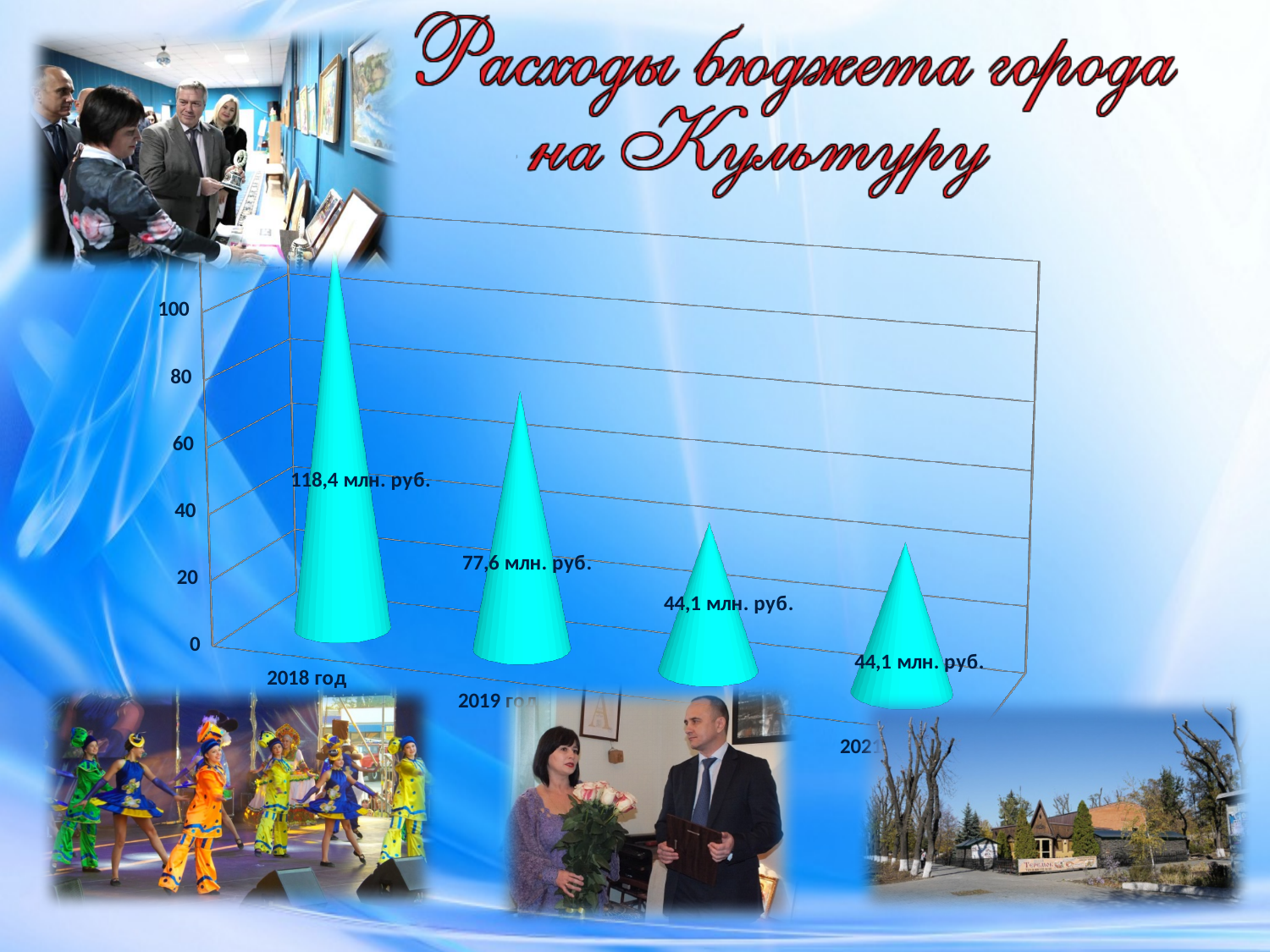
What kind of chart is shown on the slide? bar chart What is the title of the chart on the slide? Расходы бюджета города на Культуру What is the value shown for 2019 год? 77,6 млн. руб. Is the value for 2018 год greater or less than 100? greater How many cones (categories) are plotted on the chart? 4 Which is larger, the value for 2018 год or for 2019 год? 2018 год Do the values rise or fall from left to right along the x axis? fall What value is labelled on the rightmost cone? 44,1 млн. руб. What is the difference between the values for 2018 год and 2019 год? 40,8 млн. руб. What is the value shown for 2018 год? 118,4 млн. руб. Which year has the highest value on the chart? 2018 год What value is labelled on the third cone from the left? 44,1 млн. руб.